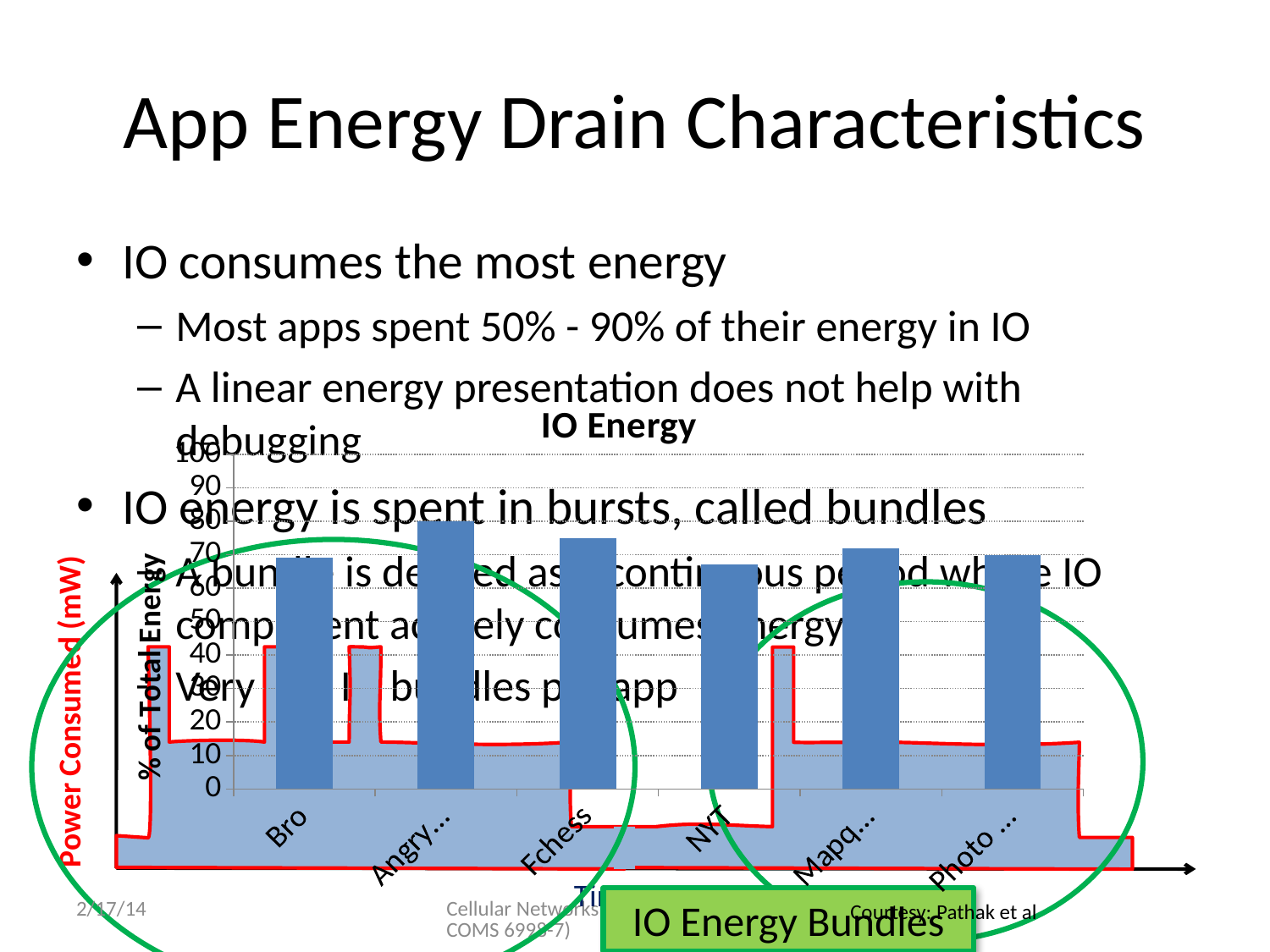
Which app has the highest bar in the "IO Energy" chart? Angry... How many apps (categories) are shown on the x axis of the "IO Energy" chart? 6 In the "IO Energy" chart, which has the larger value, Fchess or Bro? Fchess In the "IO Energy" chart, is the value for Fchess greater or less than 70? greater In the "IO Energy" chart, is the value for Photo ... greater or less than 50? greater What kind of chart is the "IO Energy" chart? bar chart In the "IO Energy" chart, which has the larger value, Angry... or NYT? Angry... What is the title of the bar chart on the slide? IO Energy In the "IO Energy" chart, is the value for Angry... greater or less than 70? greater What is the y-axis label of the "IO Energy" bar chart? % of Total Energy